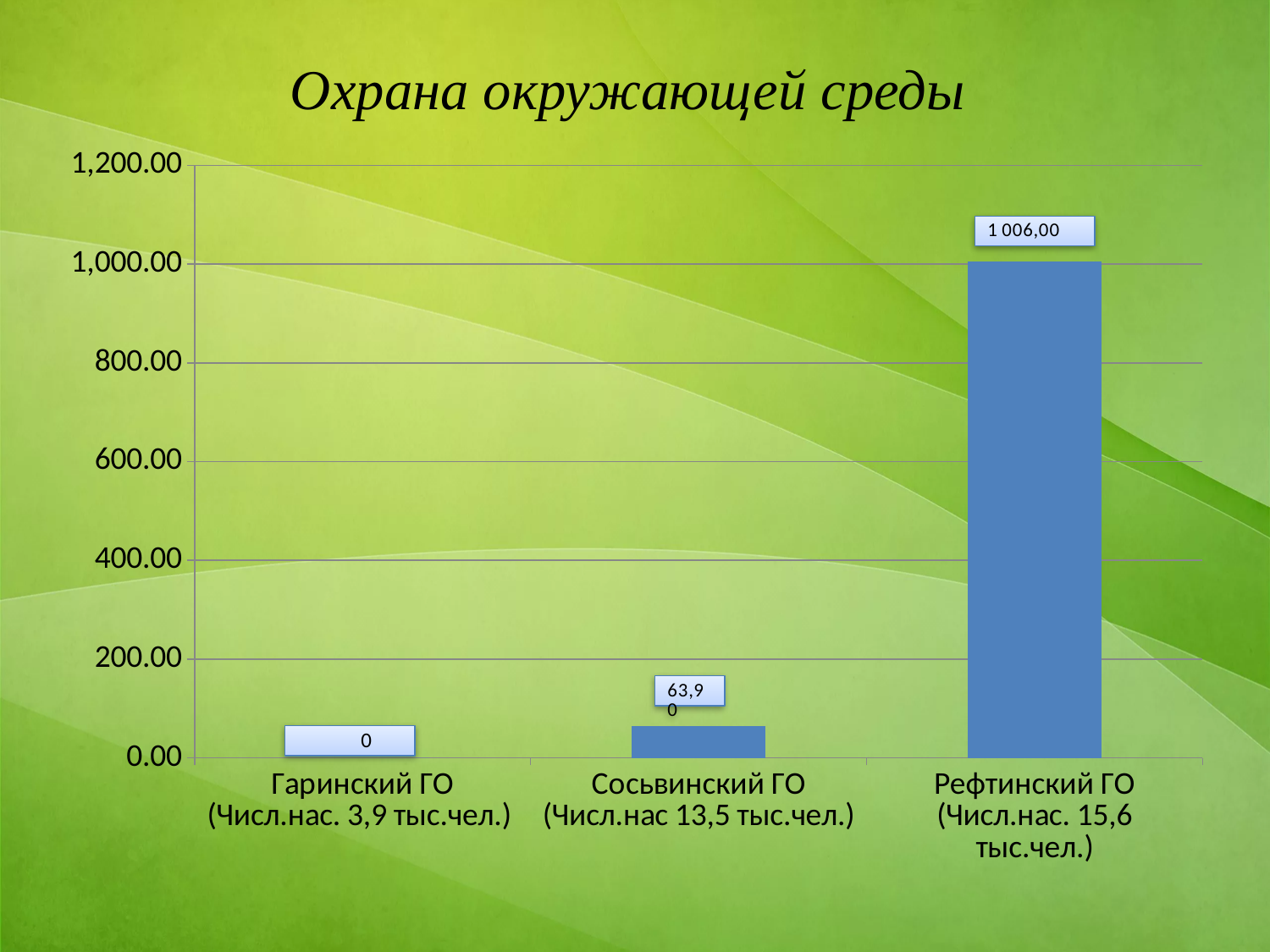
What is the value for Сосьвинский ГО? 63,90 What is the value for Рефтинский ГО? 1 006,00 What is the title of the slide? Охрана окружающей среды Which category has the highest value? Рефтинский ГО How many categories are shown on the x axis? 3 Which category has the lowest value? Гаринский ГО What kind of chart is shown on the slide? bar chart Is the value for Сосьвинский ГО greater or less than 200.00? less What is the difference between the values for Рефтинский ГО and Сосьвинский ГО? 942,10 Which is larger, the value for Сосьвинский ГО or the value for Рефтинский ГО? Рефтинский ГО What is the value for Гаринский ГО? 0 Is the value for Рефтинский ГО greater or less than 800.00? greater